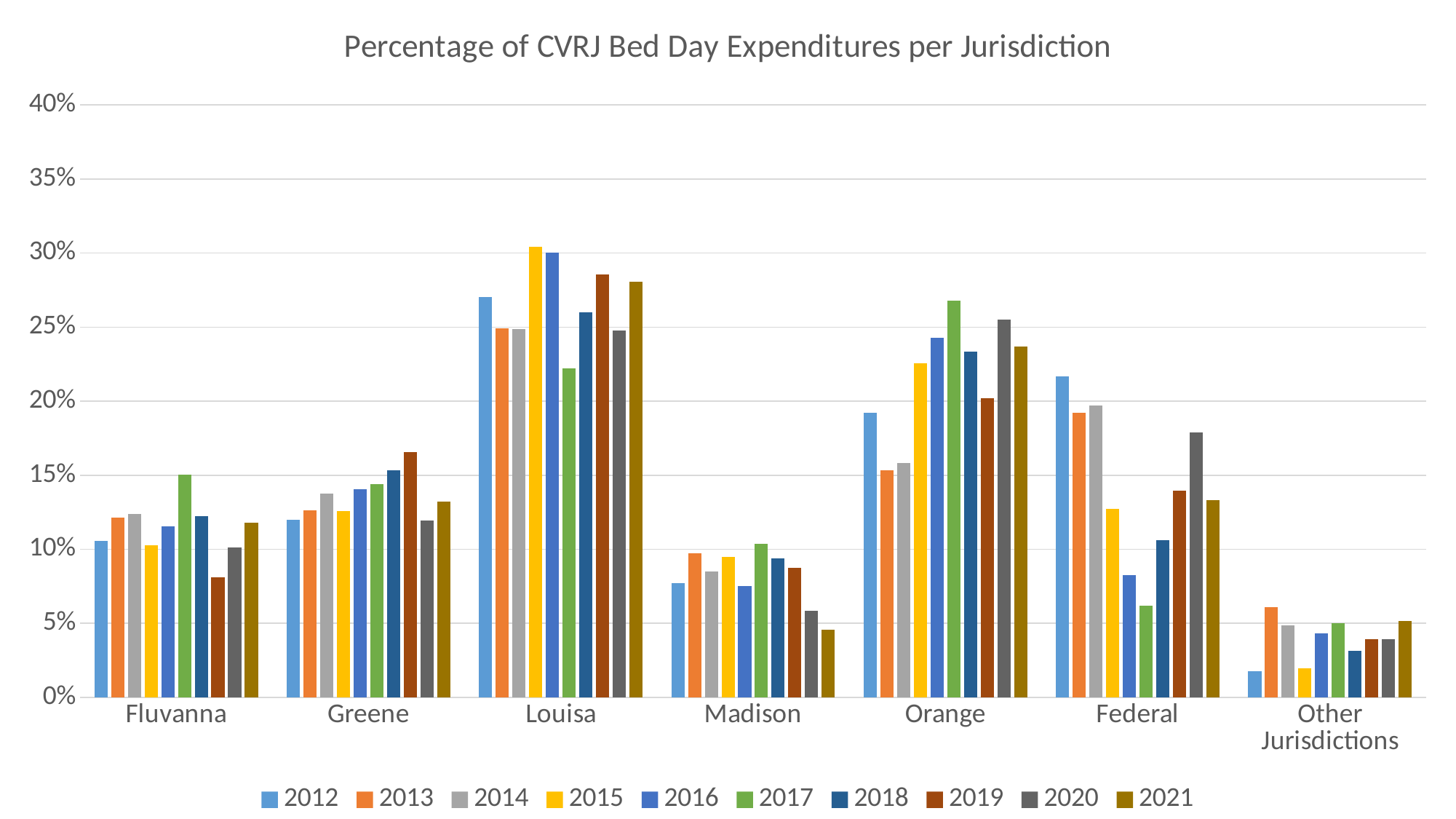
How many jurisdiction categories are shown on the x axis? 7 Is the value for Louisa in 2012 greater or less than 25%? greater What is the title of the chart? Percentage of CVRJ Bed Day Expenditures per Jurisdiction What kind of chart is shown on the slide? Bar chart How many series (years) does the legend list? 10 Which year has the lowest bar for Fluvanna? 2019 Which year has the lowest bar for Federal? 2017 Which year has the highest bar for Orange? 2017 Is the value for Federal in 2012 greater or less than 20%? greater Which jurisdiction has the highest bar for 2015? Louisa Which is larger for Federal: the 2019 value or the 2020 value? 2020 Is the value for Madison in 2021 greater or less than 5%? less